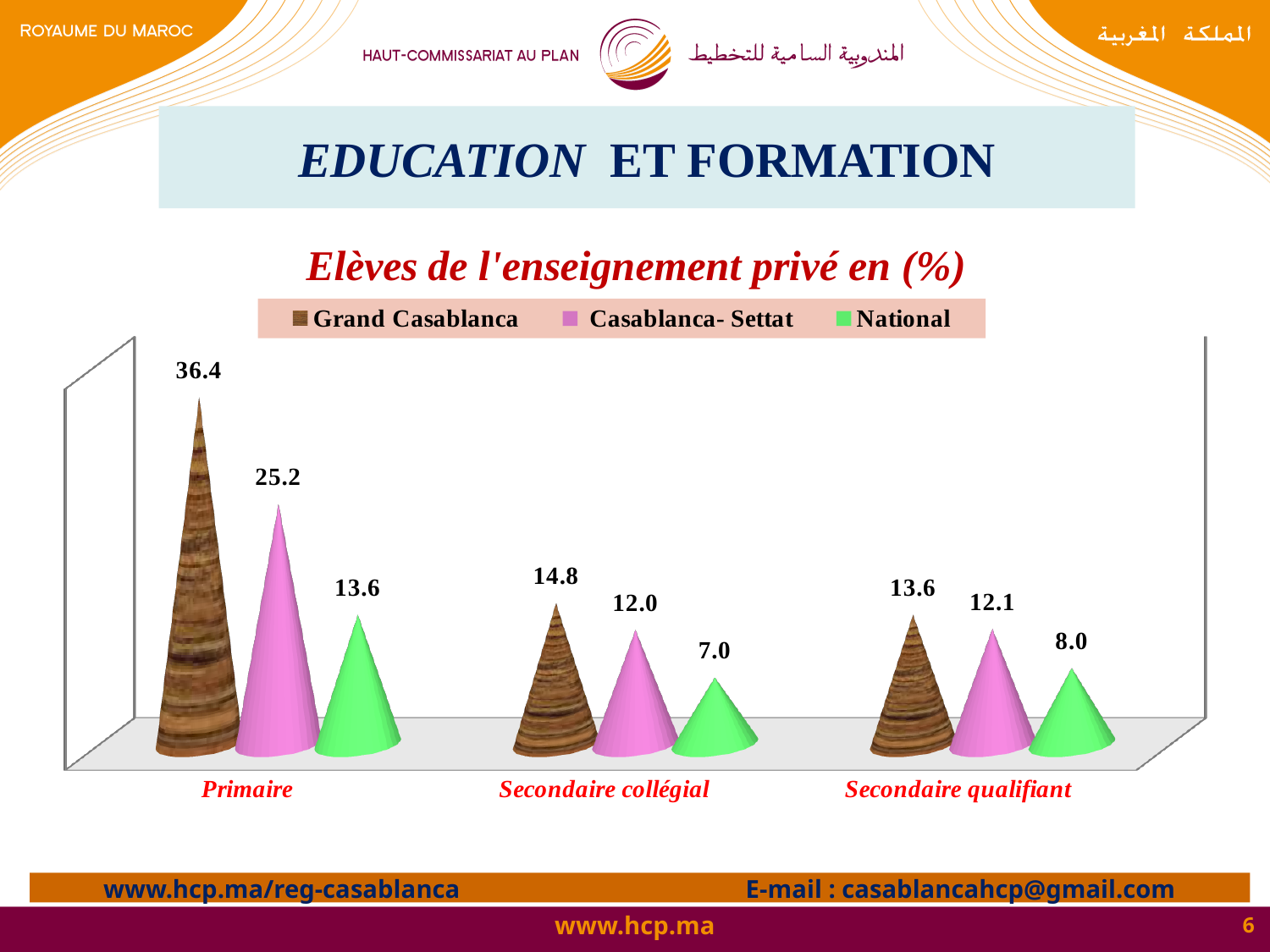
Which is larger: the Casablanca- Settat value for Primaire or the Grand Casablanca value for Secondaire collégial? Casablanca- Settat value for Primaire What is the value for Casablanca- Settat in the Secondaire qualifiant category? 12.1 How many categories are shown on the x axis? 3 Which category has the lowest value for National? Secondaire collégial What is the value for National in the Secondaire collégial category? 7.0 What is the value for Grand Casablanca in the Primaire category? 36.4 Which category has the highest value for Grand Casablanca? Primaire What is the difference between the Grand Casablanca and National values in the Primaire category? 22.8 What kind of chart is shown on the slide? Bar chart What is the title of the chart? Elèves de l'enseignement privé en (%) What is the difference between the Grand Casablanca and Casablanca- Settat values in the Secondaire collégial category? 2.8 How many series does the legend list? 3